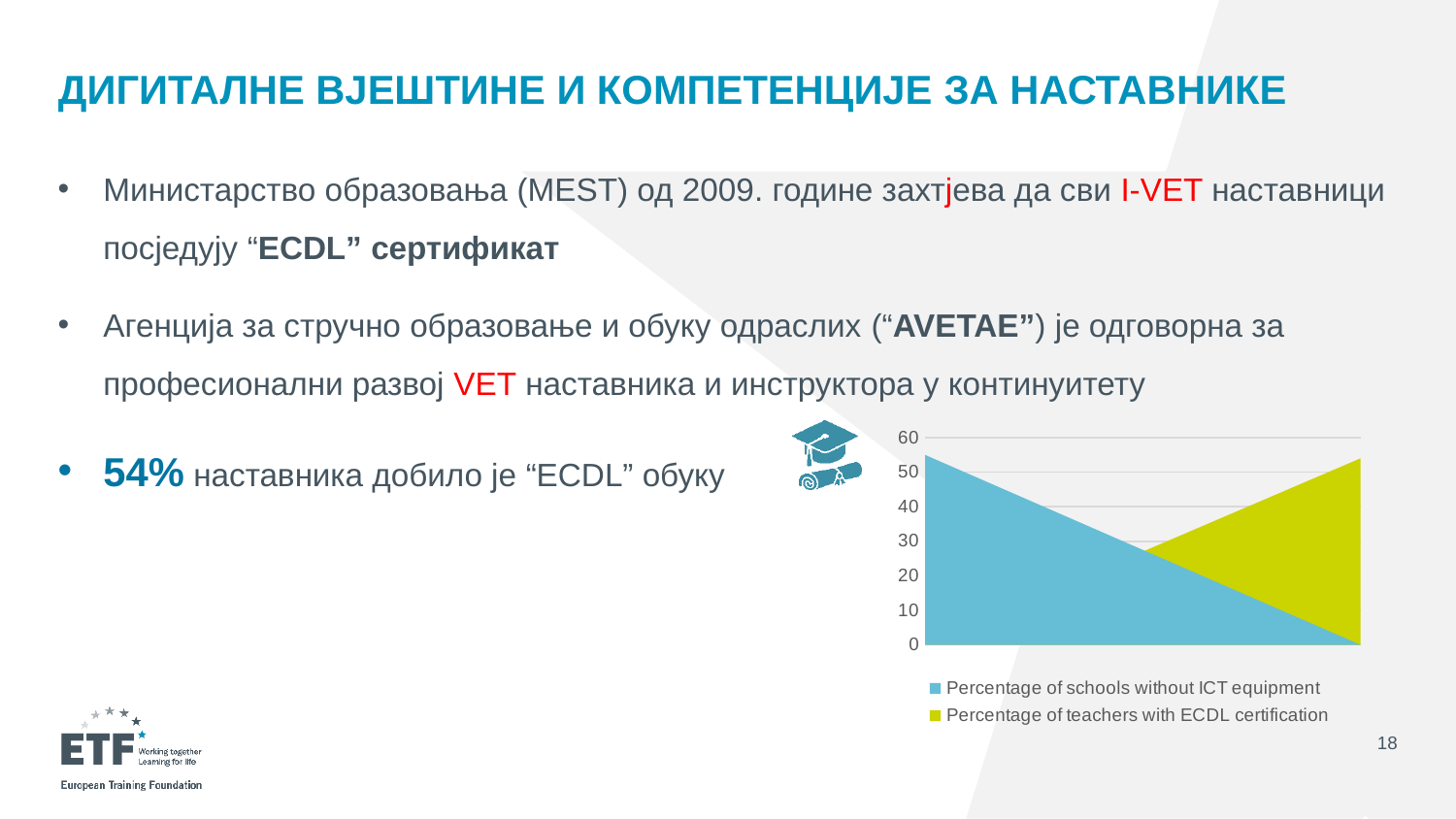
Is the starting value of 'Percentage of schools without ICT equipment' at the left of the chart greater or less than 60? less Does the 'Percentage of teachers with ECDL certification' series rise or fall from left to right? rise What is the second series listed in the chart legend? Percentage of teachers with ECDL certification Does the 'Percentage of schools without ICT equipment' series rise or fall from left to right? fall Is the starting value of 'Percentage of teachers with ECDL certification' at the left of the chart greater or less than 10? less Is the final value of 'Percentage of teachers with ECDL certification' at the right of the chart greater or less than 40? greater At the left edge of the chart, which series has the larger value: 'Percentage of schools without ICT equipment' or 'Percentage of teachers with ECDL certification'? Percentage of schools without ICT equipment How many series does the chart legend list? 2 What kind of chart is shown on the slide? area chart At the right edge of the chart, which series has the larger value: 'Percentage of schools without ICT equipment' or 'Percentage of teachers with ECDL certification'? Percentage of teachers with ECDL certification What is the first series listed in the chart legend? Percentage of schools without ICT equipment